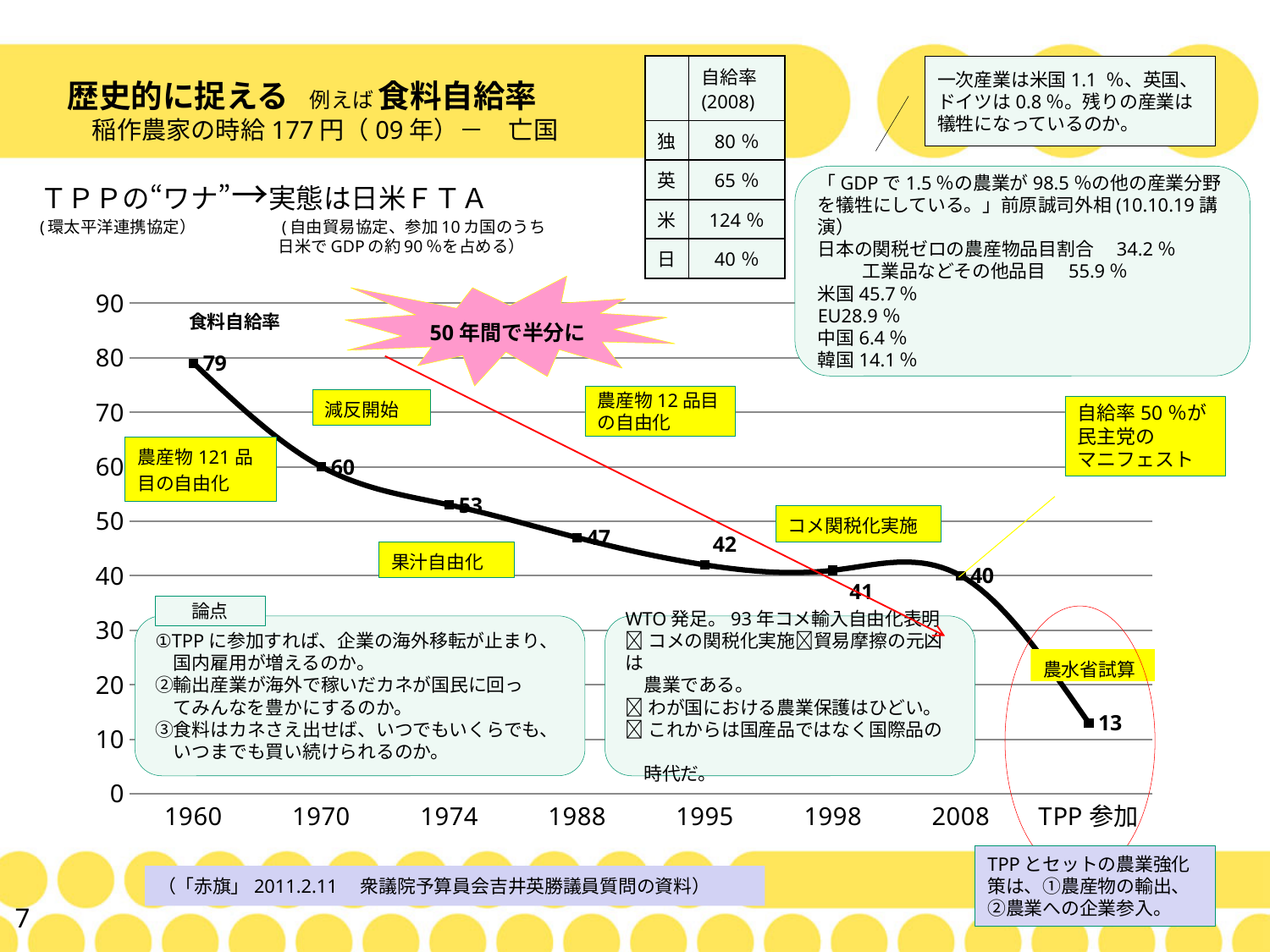
What type of chart is shown on the slide? line chart What is the 食料自給率 value plotted for 2008? 40 What value is plotted for the TPP 参加 point on the chart? 13 What is the 食料自給率 value plotted for 1960? 79 What is the difference between the 食料自給率 values for 1960 and TPP 参加? 66 What is the 食料自給率 value plotted for 1988? 47 Which is larger, the 食料自給率 value for 1970 or for 1988? 1970 Which x-axis category has the lowest 食料自給率 value? TPP 参加 Does the 食料自給率 line rise or fall from 1960 to TPP 参加 along the x axis? fall What is the 食料自給率 value plotted for 1970? 60 What is the difference between the 食料自給率 values for 1960 and 1970? 19 Which x-axis category has the highest 食料自給率 value? 1960